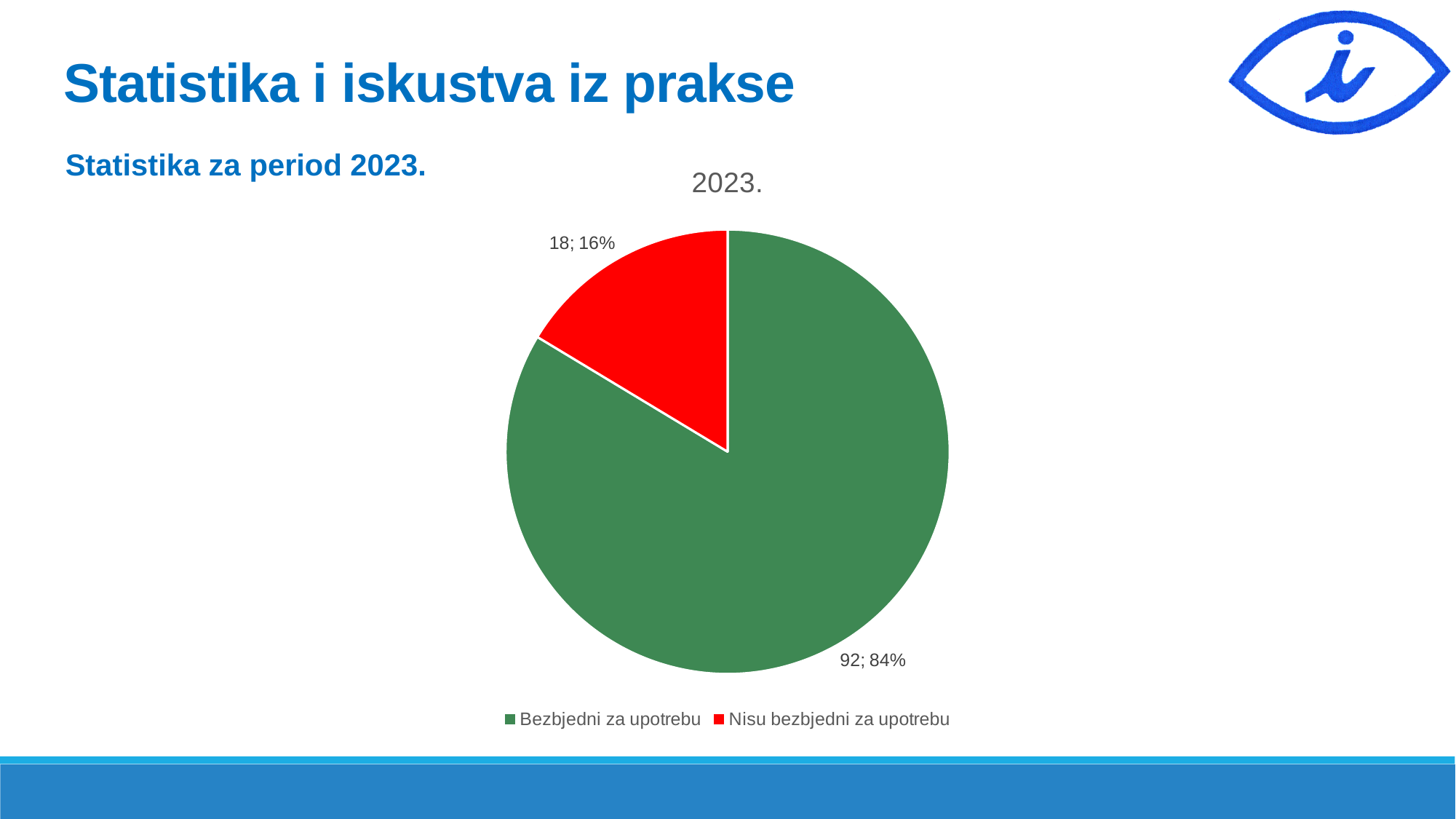
How many categories does the pie chart have? 2 What is the value for "Bezbjedni za upotrebu"? 92 Which category has the largest slice? Bezbjedni za upotrebu What colour is the slice for "Nisu bezbjedni za upotrebu"? red What is the value for "Nisu bezbjedni za upotrebu"? 18 Which category has the smallest slice? Nisu bezbjedni za upotrebu What is the title of the chart? 2023. What share of the pie does "Bezbjedni za upotrebu" represent? 84% What kind of chart is shown on the slide? pie chart Which is larger, "Bezbjedni za upotrebu" or "Nisu bezbjedni za upotrebu"? Bezbjedni za upotrebu What share of the pie does "Nisu bezbjedni za upotrebu" represent? 16% What is the difference between the values for "Bezbjedni za upotrebu" and "Nisu bezbjedni za upotrebu"? 74